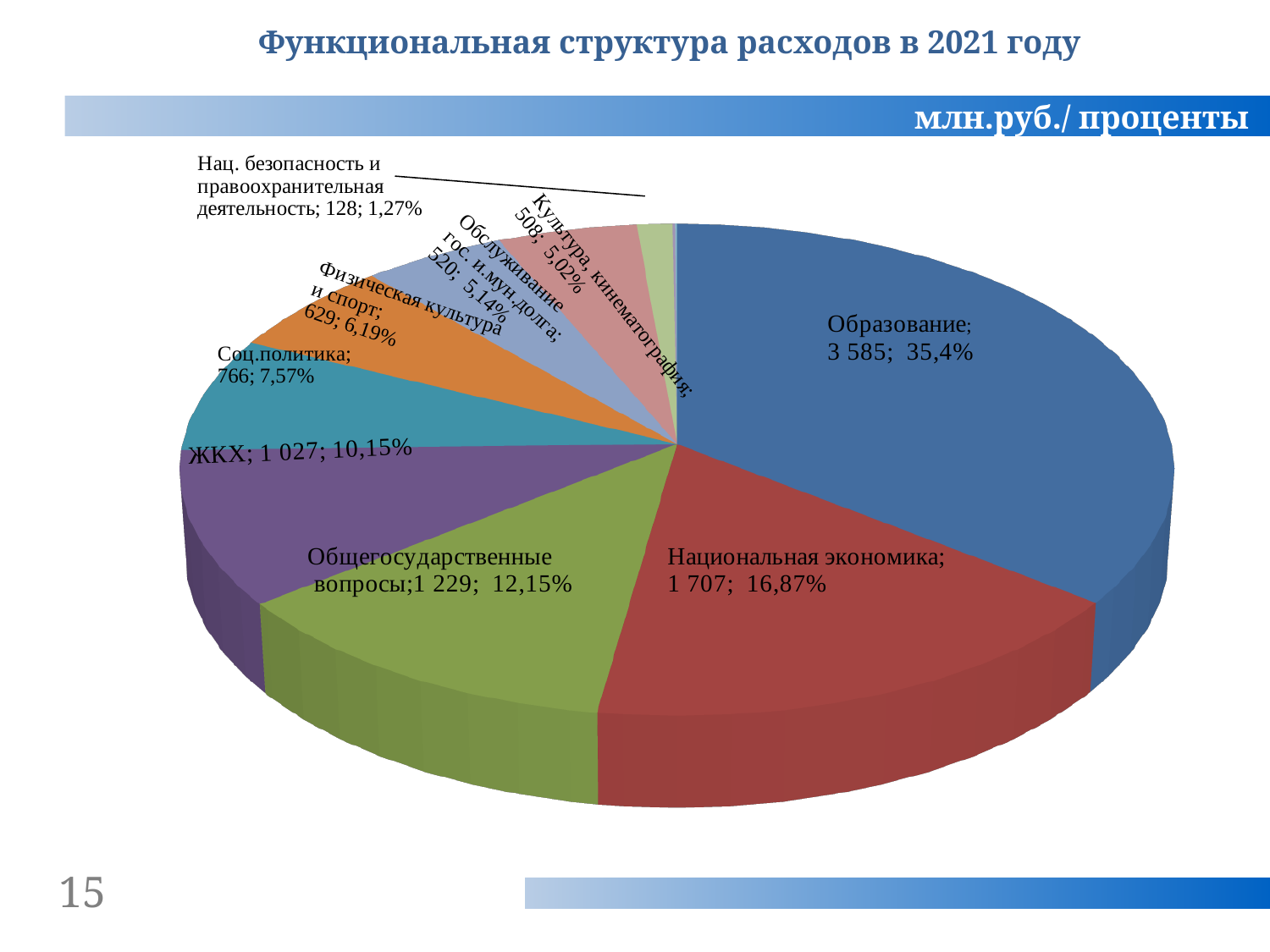
What is the value for Образование? 3 585; 35,4% Which is larger, Обслуживание гос. и мун.долга or Культура, кинематография? Обслуживание гос. и мун.долга What is the difference in млн.руб. between Образование and Национальная экономика? 1 878 What is the value in млн.руб. for Национальная экономика? 1 707 What is the value for Нац. безопасность и правоохранительная деятельность? 128; 1,27% What percentage share does Общегосударственные вопросы have? 12,15% What kind of chart is shown on the slide? Pie chart What is the value in млн.руб. for Физическая культура и спорт? 629 What percentage share does Соц.политика have? 7,57% What is the value in млн.руб. for ЖКХ? 1 027 Which labeled category has the smallest share of expenditures? Нац. безопасность и правоохранительная деятельность Which category has the largest share of expenditures? Образование